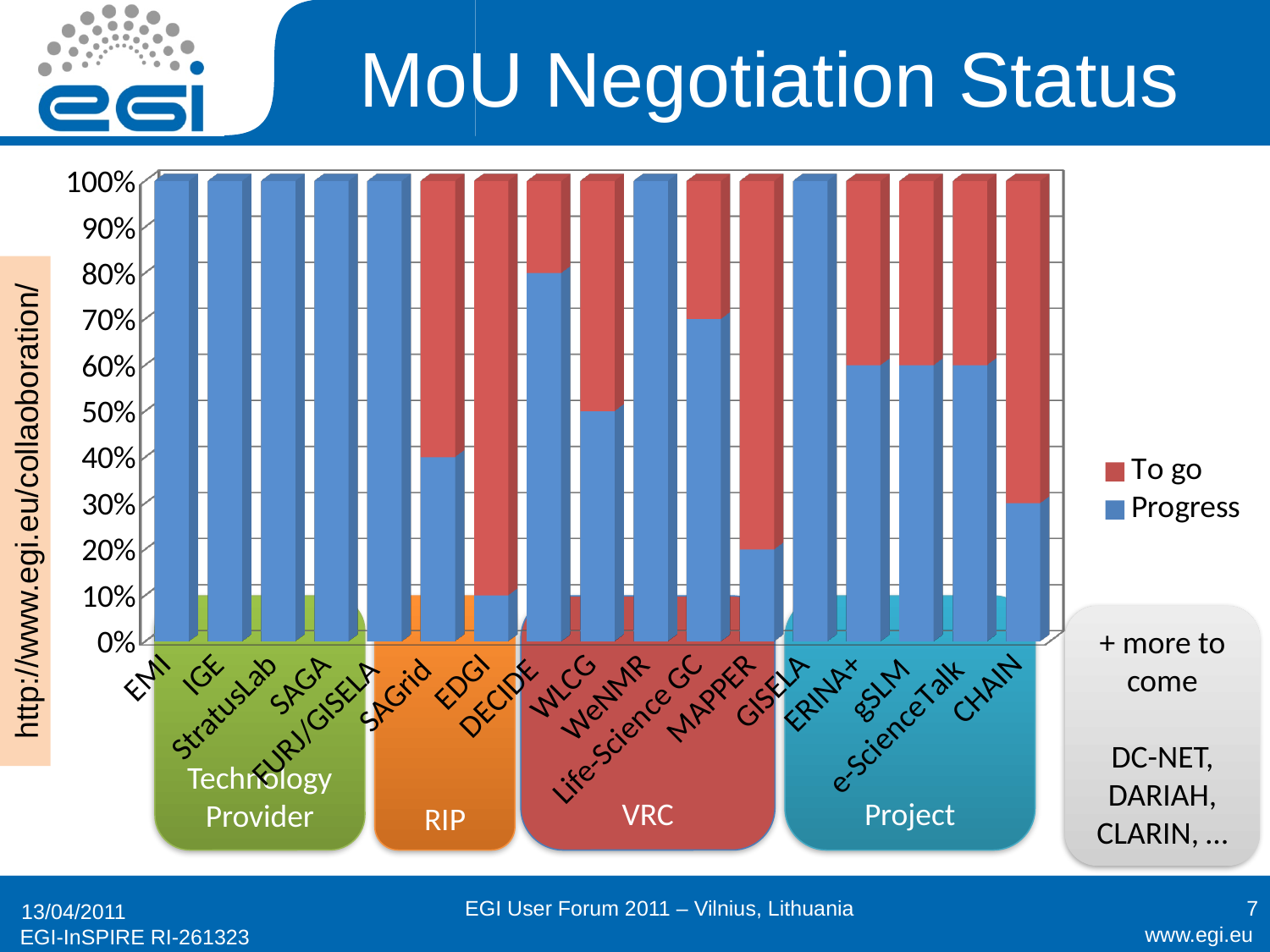
What kind of chart is shown on the slide? stacked bar chart Is the Progress value for MAPPER greater or less than 30%? less What are the two series named in the legend? To go, Progress What is the title of the slide's chart? MoU Negotiation Status How many series does the legend list? 2 Which category has the lowest Progress value? EDGI Which has the larger Progress value, MAPPER or CHAIN? CHAIN How many categories are plotted along the x axis? 17 Is the Progress value for SAGrid greater or less than 50%? less What is the Progress value for EMI? 100% Is the Progress value for DECIDE greater or less than 70%? greater Which has the larger Progress value, SAGrid or DECIDE? DECIDE